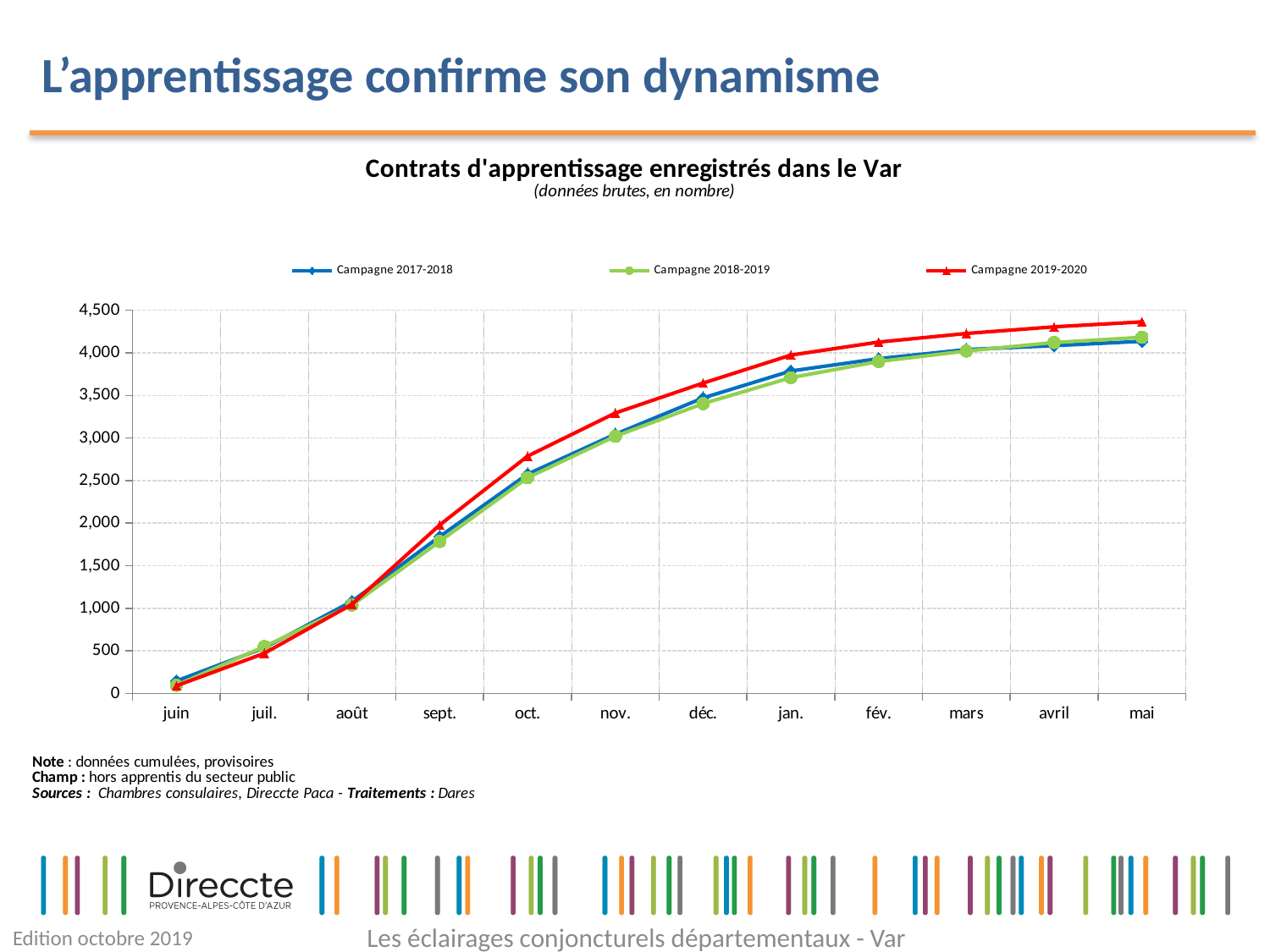
Do the values for Campagne 2019-2020 rise or fall from juin to mai? rise Is the value for Campagne 2018-2019 in déc. greater or less than 3,500? less Is the value for Campagne 2017-2018 in juin greater or less than 500? less What kind of chart is shown on the slide? line chart Is the value for Campagne 2019-2020 in mai greater or less than 4,000? greater How many series does the legend list? 3 Which series has the highest value in mai? Campagne 2019-2020 How many months are shown on the x axis? 12 In juil., which is larger: Campagne 2018-2019 or Campagne 2019-2020? Campagne 2018-2019 What is the title of the chart? Contrats d'apprentissage enregistrés dans le Var In nov., which is larger: Campagne 2019-2020 or Campagne 2018-2019? Campagne 2019-2020